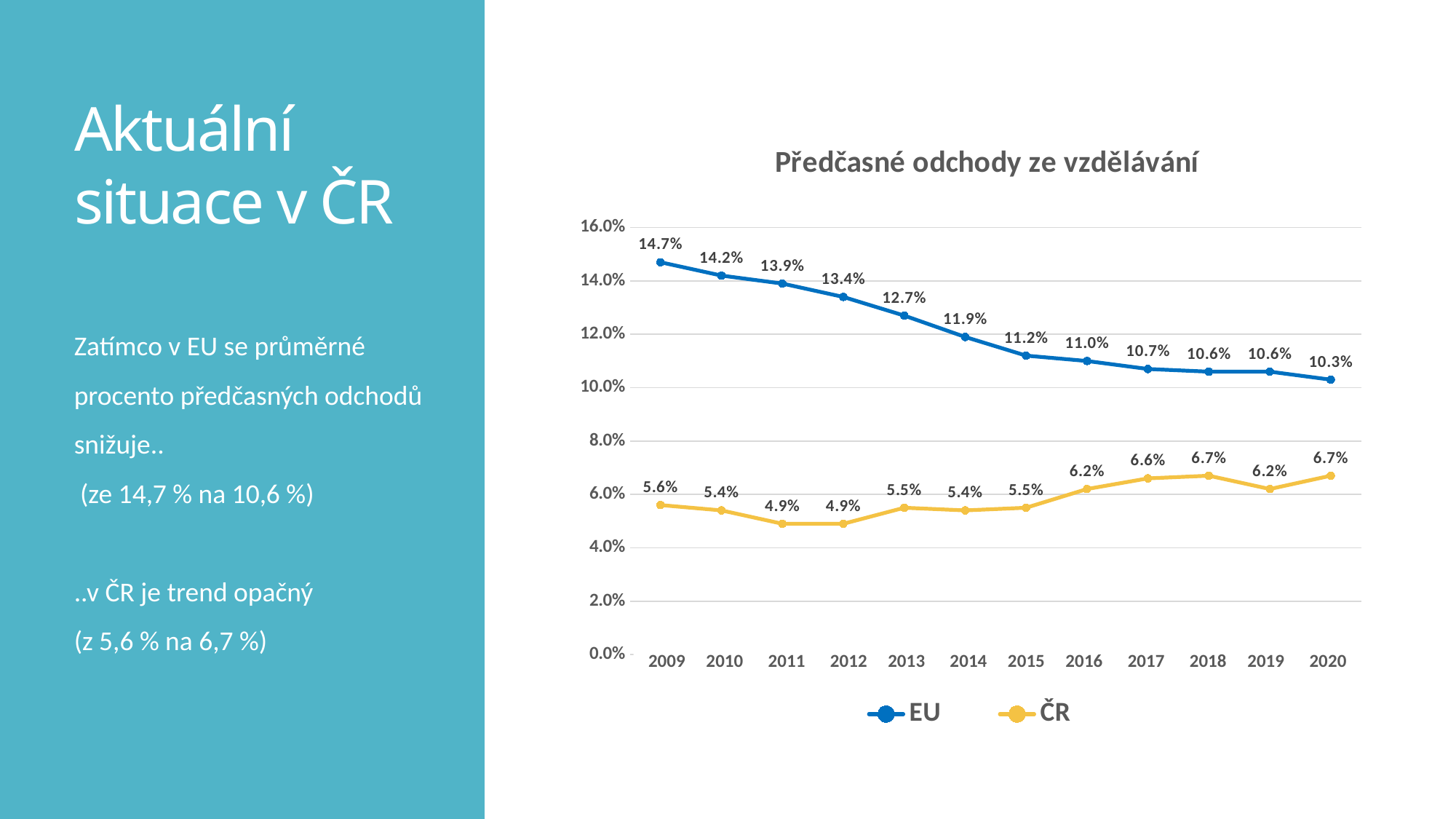
What is the EU value for 2009? 14.7% What kind of chart is shown? line chart What is the difference between the EU and ČR values in 2009? 9.1% Does the EU series rise or fall from 2009 to 2020? fall Is the ČR value for 2011 greater or less than 6.0%? less How many series does the legend list? 2 Which is larger in 2020, the EU value or the ČR value? EU What is the ČR value for 2020? 6.7% In which year is the EU series lowest? 2020 In which year is the ČR series highest, among the years where it reaches its peak value of 6.7%? 2018 and 2020 How many years are shown on the x axis? 12 What is the EU value for 2015? 11.2%